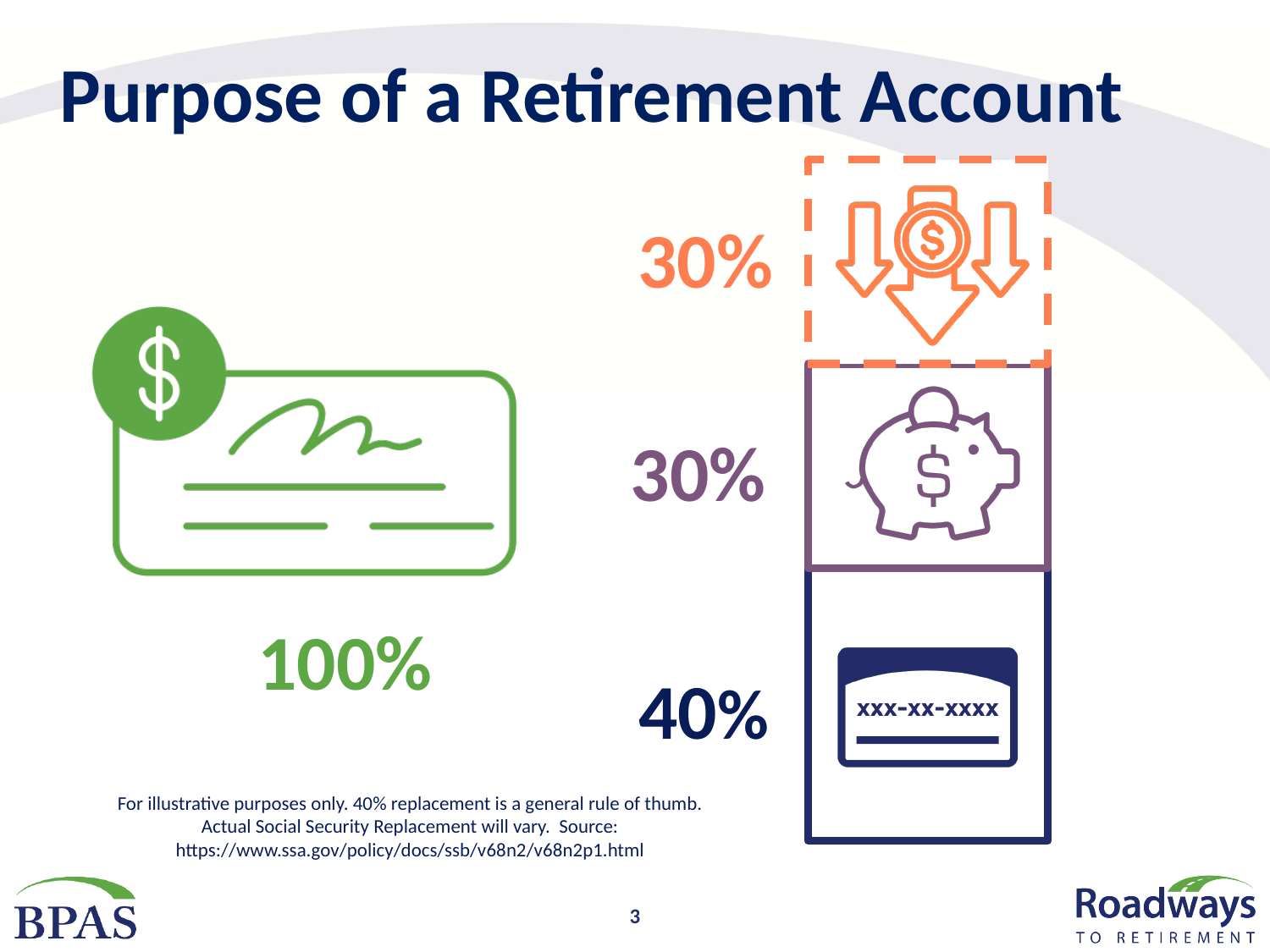
Is the bottom navy segment larger or smaller than the top orange segment? Larger Which segment of the stacked bar has the largest percentage? The bottom navy segment (40%) What is the difference between the bottom navy segment and the middle purple segment? 10% What colour is the segment labelled 40%? Navy blue What percentage is shown for the middle, purple segment with the piggy bank icon? 30% What percentage is shown beneath the green check graphic on the left? 100% How many segments make up the stacked bar on the right? 3 What is the title of the slide? Purpose of a Retirement Account What is the total of the three segments in the stacked bar? 100% What percentage is shown for the top, orange dashed segment of the stacked bar? 30% What percentage is shown for the bottom, navy segment with the Social Security card icon? 40% What kind of chart is shown on the right of the slide? Stacked bar chart